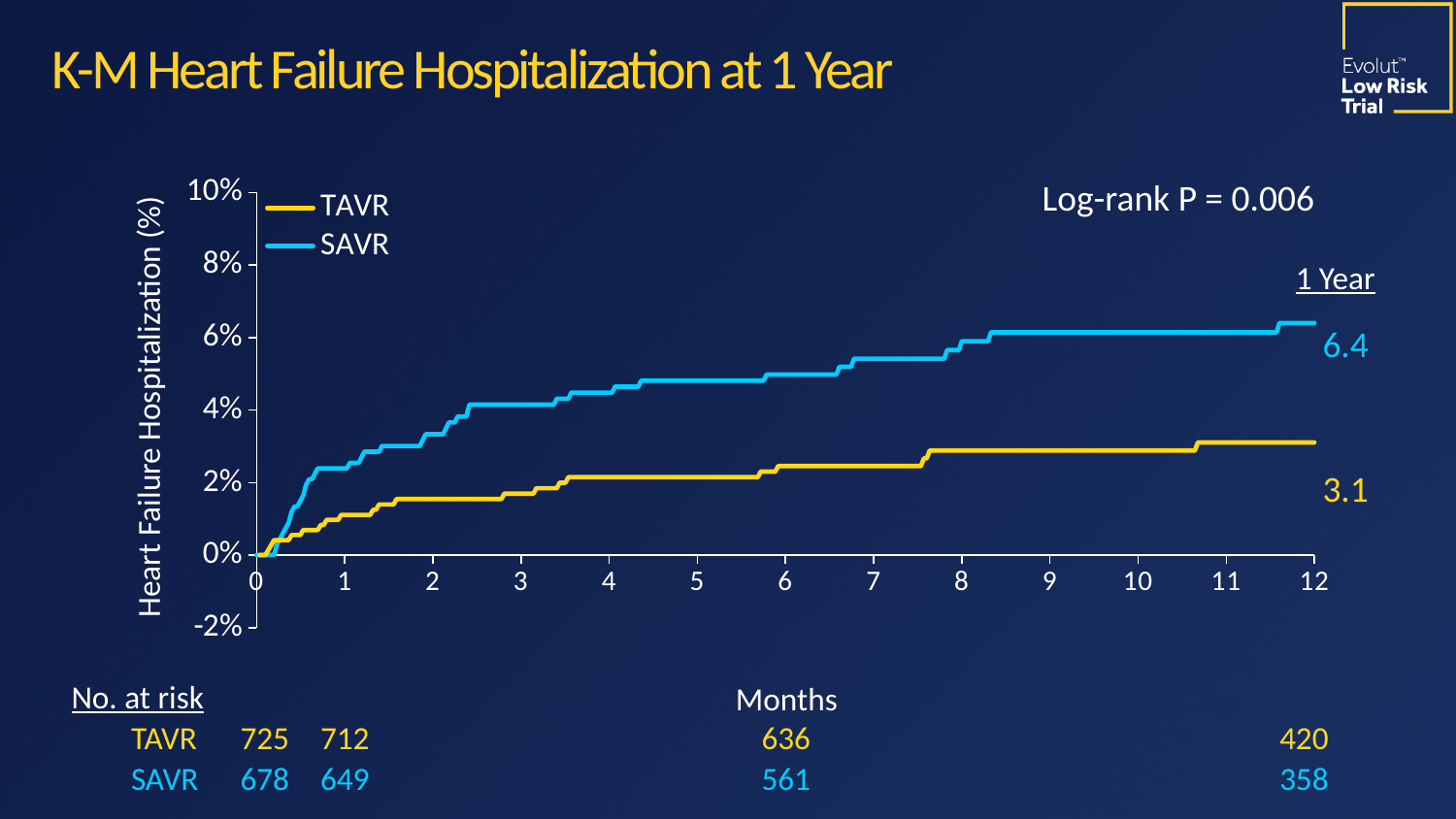
How many TAVR patients are at risk at month 0 according to the number-at-risk table? 725 Which group has the higher heart failure hospitalization rate at 1 year, TAVR or SAVR? SAVR What is the difference between the SAVR and TAVR heart failure hospitalization rates at 1 year? 3.3 What kind of chart is shown on the slide? Line chart (Kaplan-Meier curve) Is the SAVR heart failure hospitalization rate at month 6 greater or less than 4%? greater What is the heart failure hospitalization rate for TAVR at 1 year? 3.1 What is the log-rank P value shown on the chart? 0.006 How many series does the legend list? 2 Which colour represents the SAVR curve? Blue Is the TAVR heart failure hospitalization rate at month 6 greater or less than 4%? less Do the heart failure hospitalization curves rise or fall as months increase? Rise What is the heart failure hospitalization rate for SAVR at 1 year? 6.4